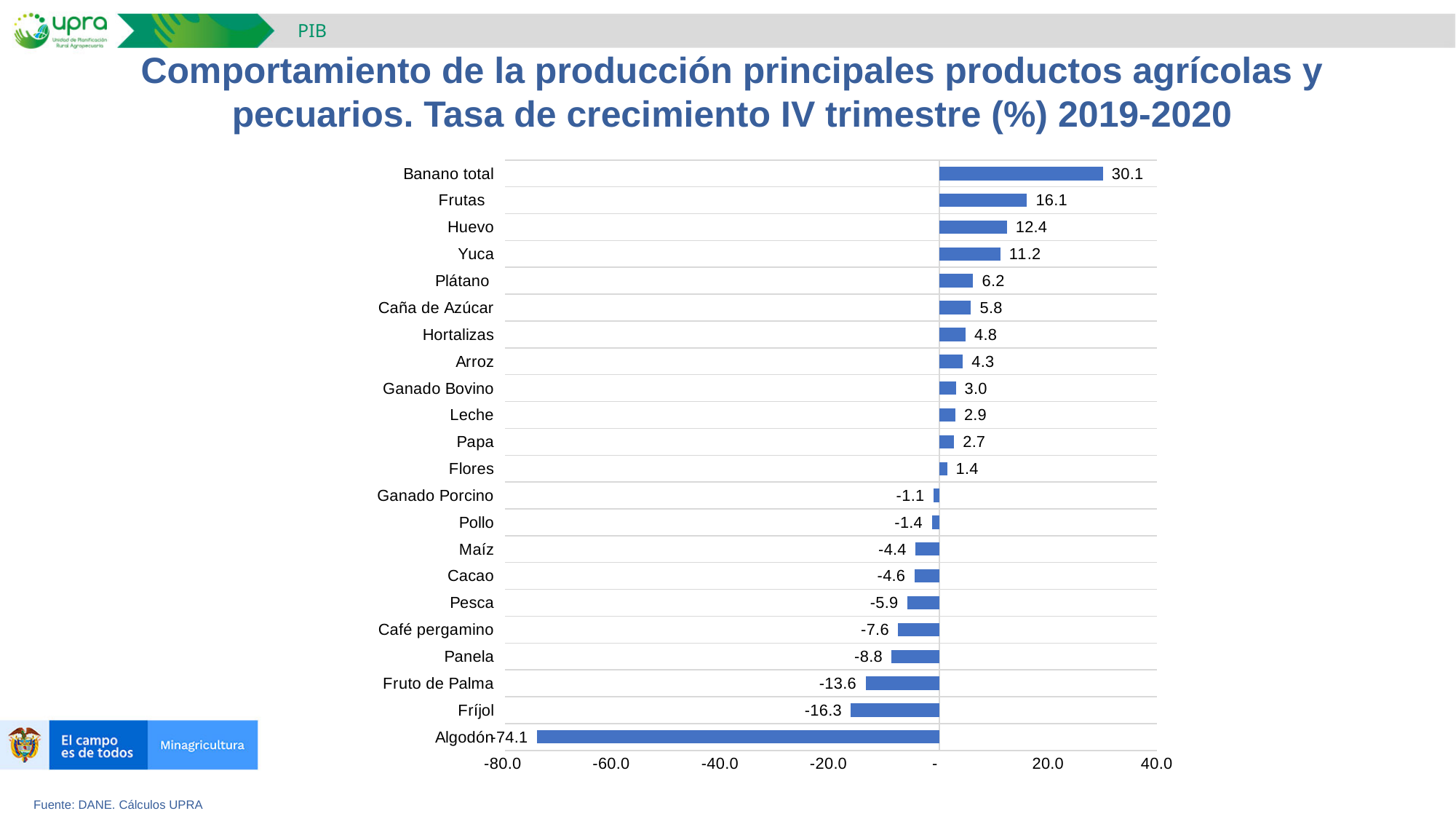
Which has a higher value, Plátano or Hortalizas? Plátano How many products are shown in the chart? 22 What is the value shown for Fruto de Palma? -13.6 What is the growth rate shown for Banano total? 30.1 What kind of chart is shown on the slide? Bar chart Is the value for Algodón greater or less than -60.0? less What source is cited for the chart data? DANE. Cálculos UPRA What is the value shown for Caña de Azúcar? 5.8 What is the difference between the values for Huevo and Yuca? 1.2 Which product has the highest growth rate in the chart? Banano total Which product has the lowest growth rate in the chart? Algodón What is the difference between the values for Banano total and Frutas? 14.0